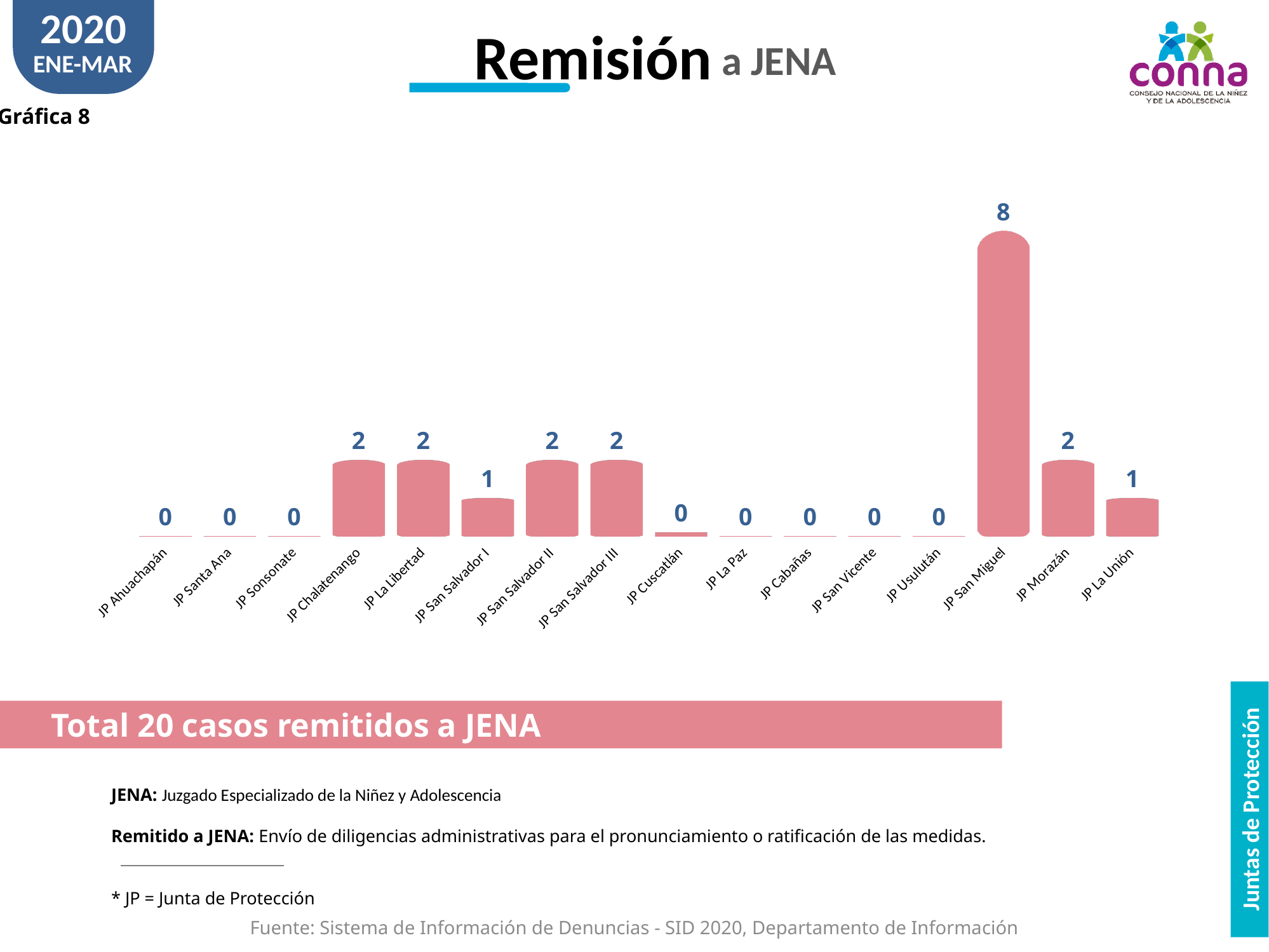
What is the value for JP Chalatenango? 2 Which category has the highest value? JP San Miguel What is the total number of cases remitted to JENA according to the slide? 20 What is the difference between the values for JP San Miguel and JP Morazán? 6 What is the value for JP San Salvador I? 1 Which is larger, the value for JP La Unión or the value for JP La Libertad? JP La Libertad What is the title of the chart on the slide? Remisión a JENA How many categories have a value of 0? 8 How many categories are shown on the x axis of the chart? 16 What is the value for JP San Miguel? 8 What is the value for JP Cuscatlán? 0 What kind of chart is shown on the slide? bar chart